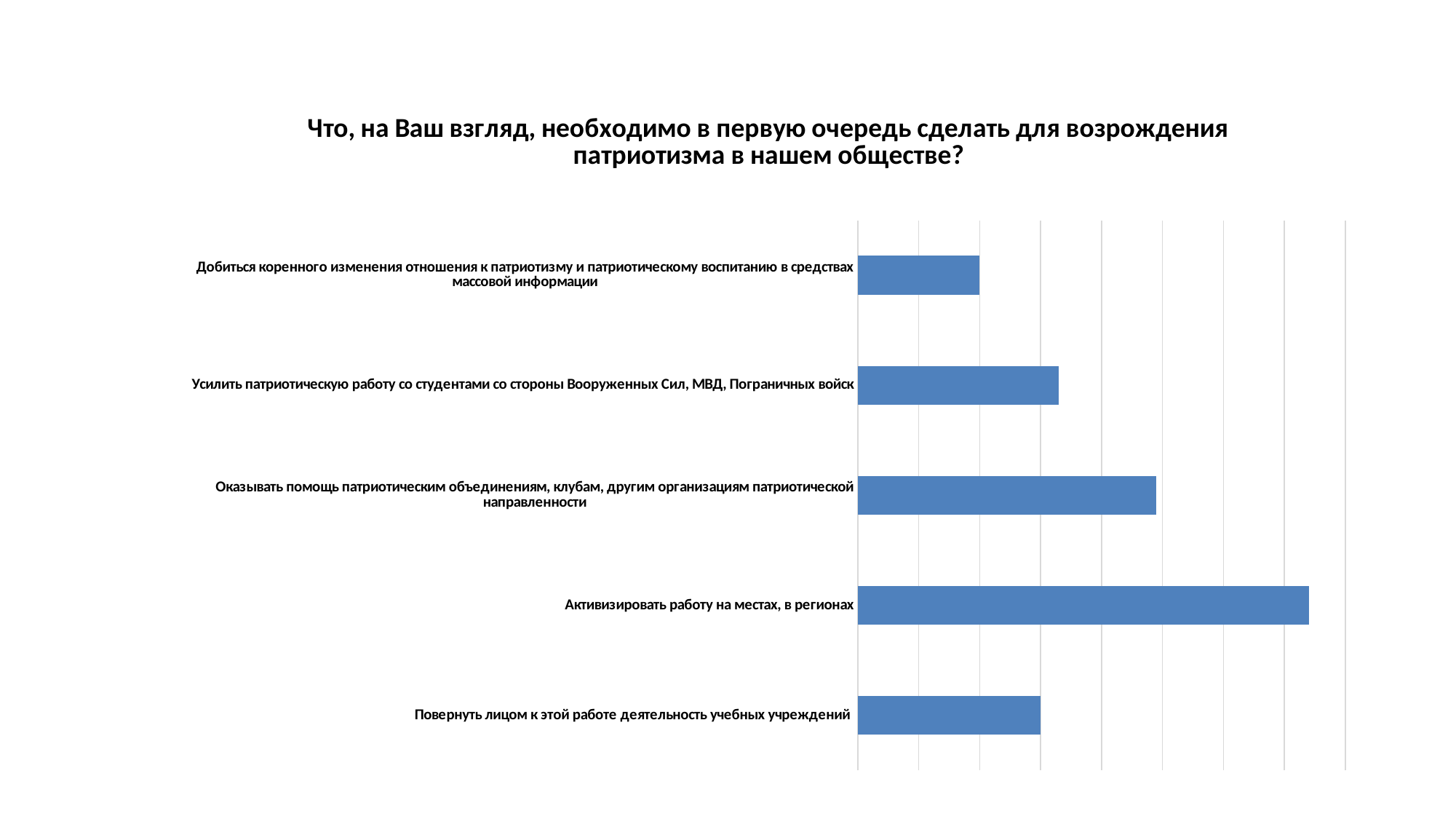
What colour are the bars in the chart? blue Which category has the shortest bar in the chart? Добиться коренного изменения отношения к патриотизму и патриотическому воспитанию в средствах массовой информации Are the bars in the chart horizontal or vertical? horizontal Which category has the longest bar in the chart? Активизировать работу на местах, в регионах Which category has the second longest bar in the chart? Оказывать помощь патриотическим объединениям, клубам, другим организациям патриотической направленности Which bar is longer: "Активизировать работу на местах, в регионах" or "Оказывать помощь патриотическим объединениям, клубам, другим организациям патриотической направленности"? Активизировать работу на местах, в регионах How many categories are plotted in the chart? 5 What kind of chart is shown on the slide? bar chart Which bar is longer: "Повернуть лицом к этой работе деятельность учебных учреждений" or "Добиться коренного изменения отношения к патриотизму и патриотическому воспитанию в средствах массовой информации"? Повернуть лицом к этой работе деятельность учебных учреждений What is the title of the chart? Что, на Ваш взгляд, необходимо в первую очередь сделать для возрождения патриотизма в нашем обществе? Which bar is longer: "Оказывать помощь патриотическим объединениям, клубам, другим организациям патриотической направленности" or "Усилить патриотическую работу со студентами со стороны Вооруженных Сил, МВД, Пограничных войск"? Оказывать помощь патриотическим объединениям, клубам, другим организациям патриотической направленности